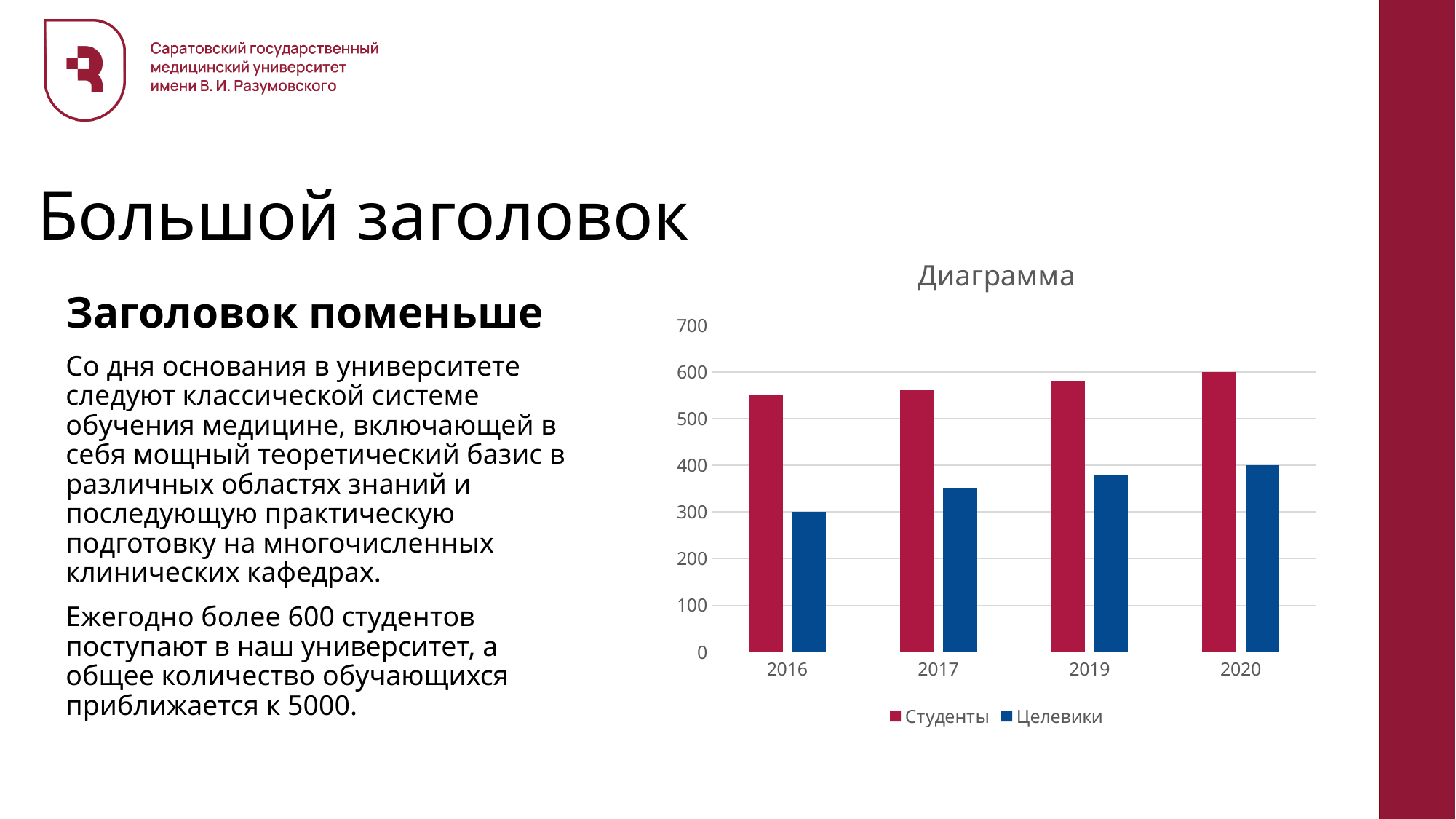
Do the values for Целевики rise or fall from 2016 to 2020? rise Which series is shown in blue in the chart? Целевики What is the value for Целевики in 2020? 400 In which year is the value for Студенты the highest? 2020 What kind of chart is shown on the slide? bar chart What is the title of the chart? Диаграмма What is the value for Целевики in 2016? 300 Is the value for Целевики in 2019 greater or less than 400? less Is the value for Студенты in 2016 greater or less than 500? greater In which year is the value for Целевики the lowest? 2016 How many series does the legend of the chart list? 2 How many years are shown on the x axis of the chart? 4